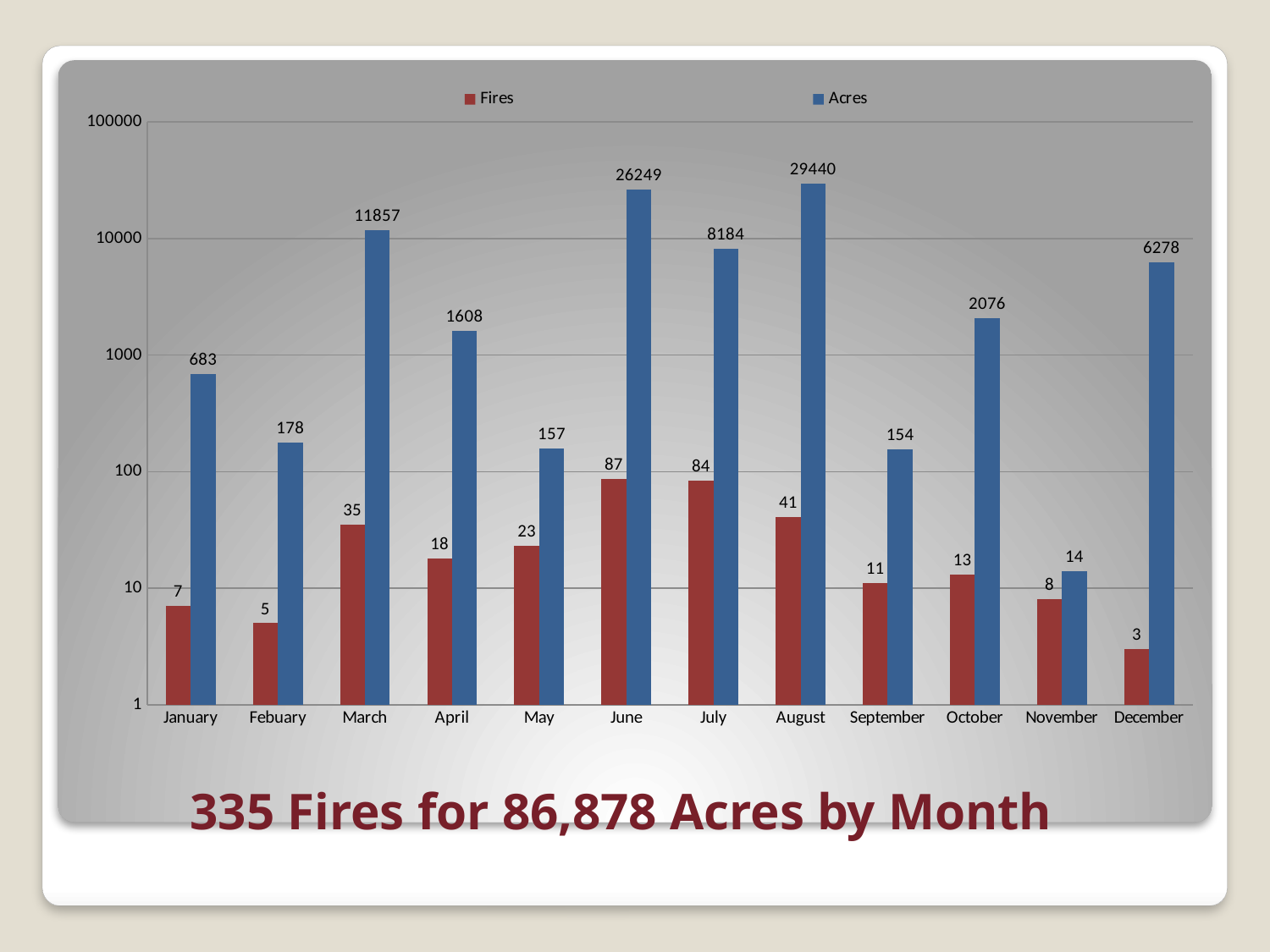
Which month had the most acres burned? August How many acres burned in August? 29440 Which month had more fires, March or August? August How many series does the legend list? 2 How many fires occurred in June? 87 Which month had the fewest fires? December Which colour represents the Acres series? Blue What is the difference between the number of fires in June and July? 3 What is the difference in acres burned between August and June? 3191 How many months are shown on the x axis? 12 What is the title shown below the chart? 335 Fires for 86,878 Acres by Month What kind of chart is shown on the slide? Bar chart